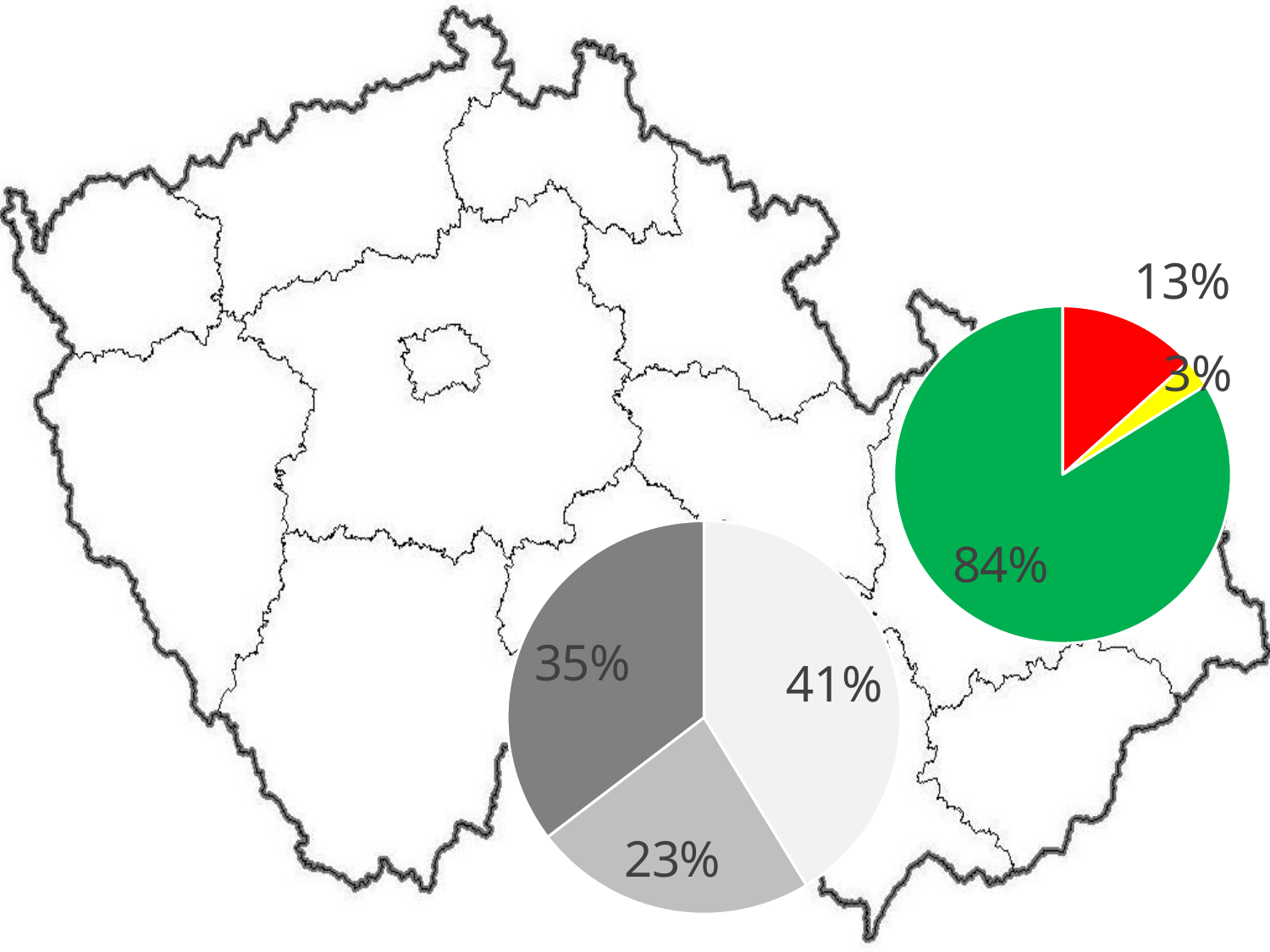
In the upper-right pie chart, what share does the green slice have? 84% In the upper-right pie chart, which slice is the smallest? the yellow slice (3%) In the lower pie chart, what is the difference between the largest slice (41%) and the smallest slice (23%)? 18 percentage points How many slices does the upper-right pie chart have? 3 In the upper-right pie chart, which slice is the largest? the green slice (84%) In the upper-right pie chart, what share does the yellow slice have? 3% In the upper-right pie chart, what share does the red slice have? 13% How many slices does the lower pie chart have? 3 What type of chart is the upper-right chart on the slide? pie chart What type of chart is the lower chart on the slide? pie chart